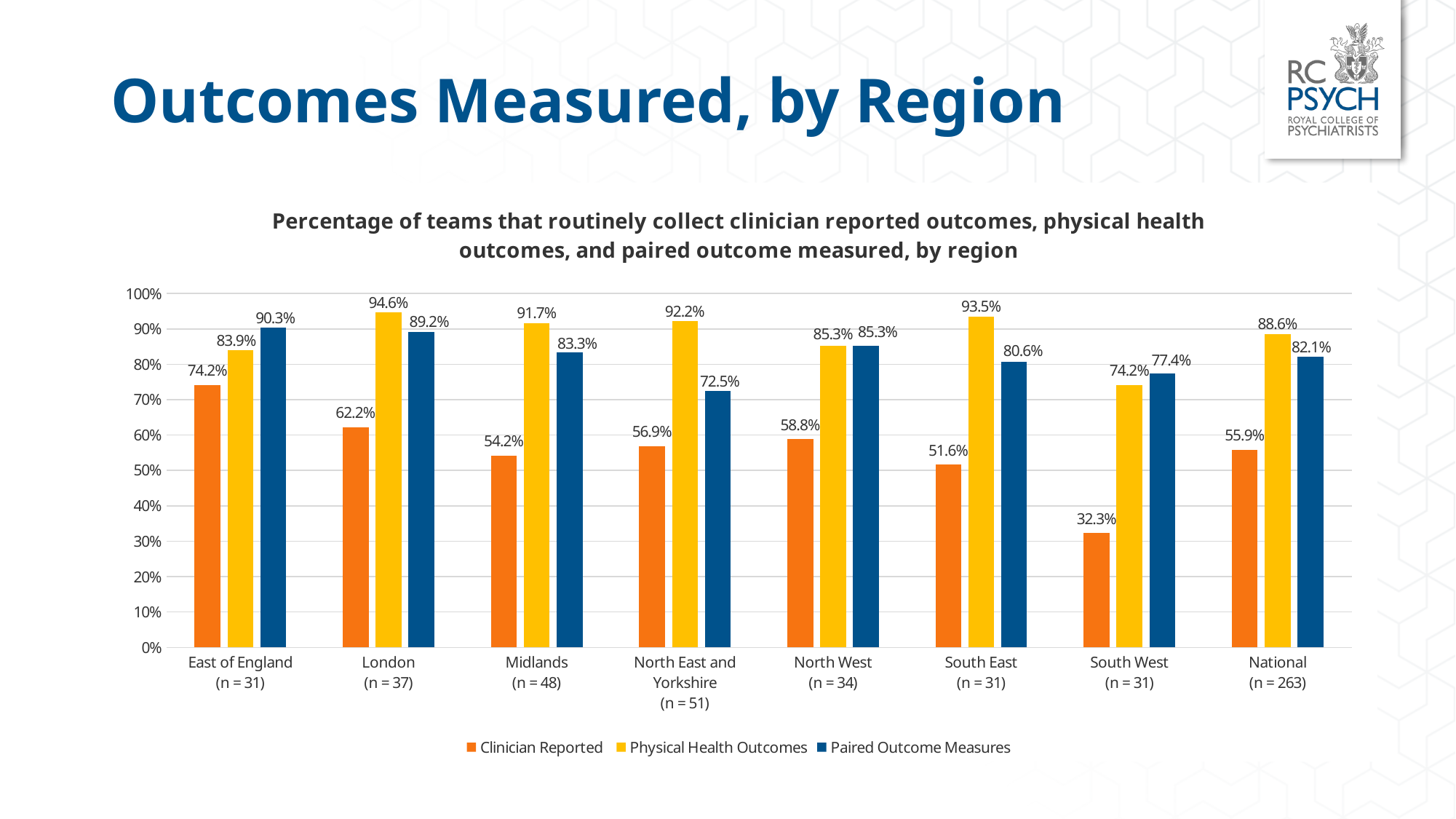
Which region has the highest Physical Health Outcomes value? London How many regions (categories) are shown on the x axis? 8 Which region has the highest Paired Outcome Measures value? East of England How many series does the legend list? 3 Which region has the lowest Clinician Reported value? South West What is the Clinician Reported value for London? 62.2% What is the difference between the Physical Health Outcomes and Clinician Reported values for Midlands? 37.5% What is the sample size (n) shown for the National category? 263 What is the Paired Outcome Measures value for National? 82.1% What kind of chart is shown on the slide? Bar chart Which is larger for North East and Yorkshire: Physical Health Outcomes or Paired Outcome Measures? Physical Health Outcomes What is the Physical Health Outcomes value for South East? 93.5%